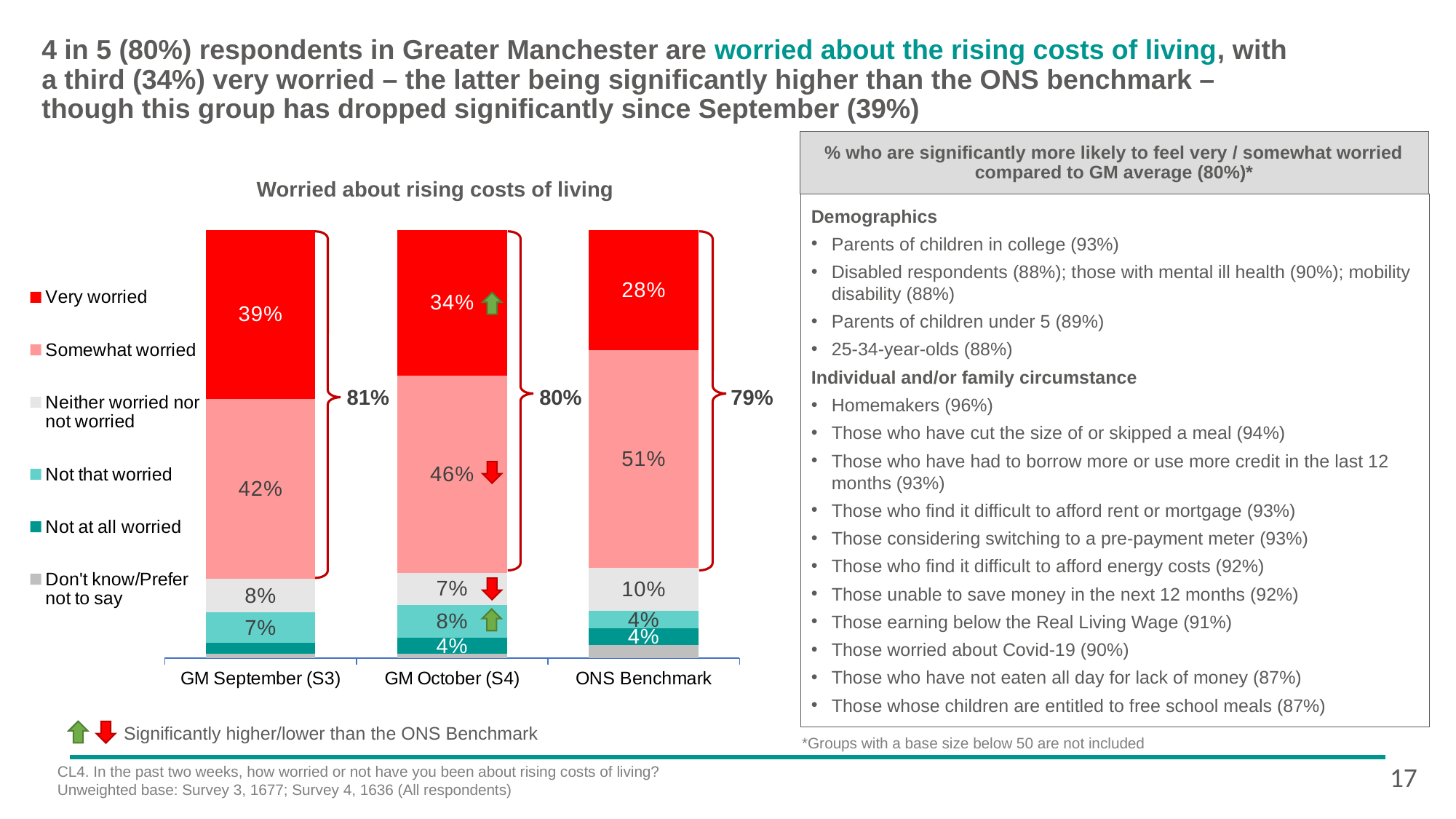
Which of the three bars has the lowest 'Somewhat worried' percentage? GM September (S3) How many response categories does the chart legend list? 6 What percentage of GM September (S3) respondents were very worried about rising costs of living? 39% Which of the three bars has the highest 'Very worried' percentage? GM September (S3) Is the 'Somewhat worried' share larger for GM October (S4) or for the ONS Benchmark? ONS Benchmark How many bars (survey groups) are shown on the chart? 3 What percentage of GM October (S4) respondents were neither worried nor not worried? 7% What type of chart is used to show 'Worried about rising costs of living'? Stacked bar chart What percentage of ONS Benchmark respondents were somewhat worried? 51% Does the 'Very worried' percentage rise or fall moving from GM September (S3) to GM October (S4) to ONS Benchmark? Fall What combined very/somewhat worried percentage is shown by the bracket for the ONS Benchmark bar? 79% By how many percentage points did the 'Very worried' share fall from GM September (S3) to GM October (S4)? 5 percentage points